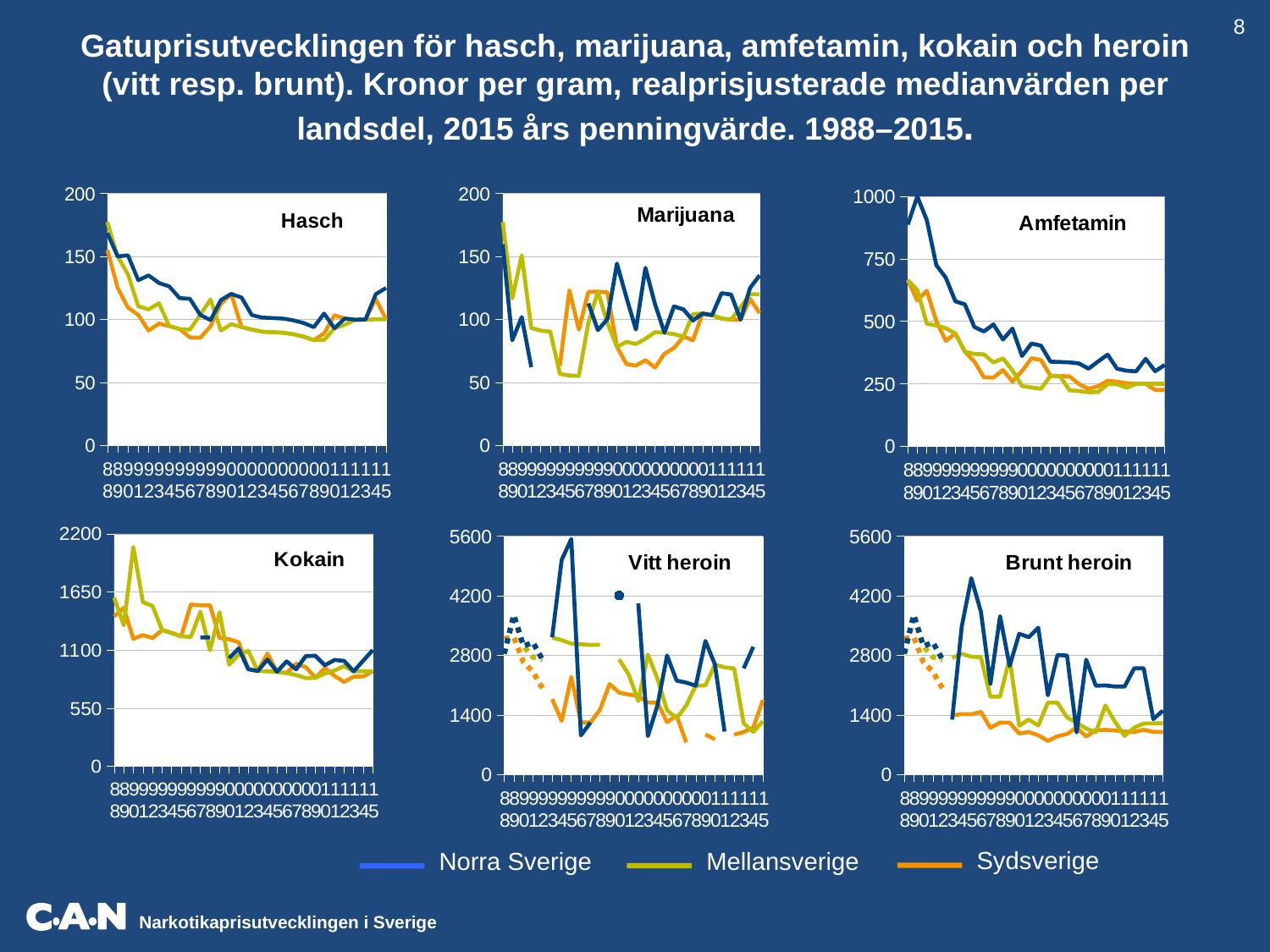
In the Brunt heroin chart, is the highest value for Norra Sverige greater or less than 4200? greater In the Amfetamin chart, is the value for Norra Sverige in 2015 greater or less than 250? greater How many charts are on the slide? 6 Which chart has a y-axis that goes up to 2200? Kokain What kind of charts are shown on the slide? Line charts In the Vitt heroin chart, is the highest value for Norra Sverige greater or less than 4200? greater In the Hasch chart, do the prices generally rise or fall over the period? Fall How many series does the legend list? 3 Which three regions are listed in the legend? Norra Sverige, Mellansverige, Sydsverige In the Amfetamin chart, do the prices generally rise or fall from 1988 to 2015? Fall